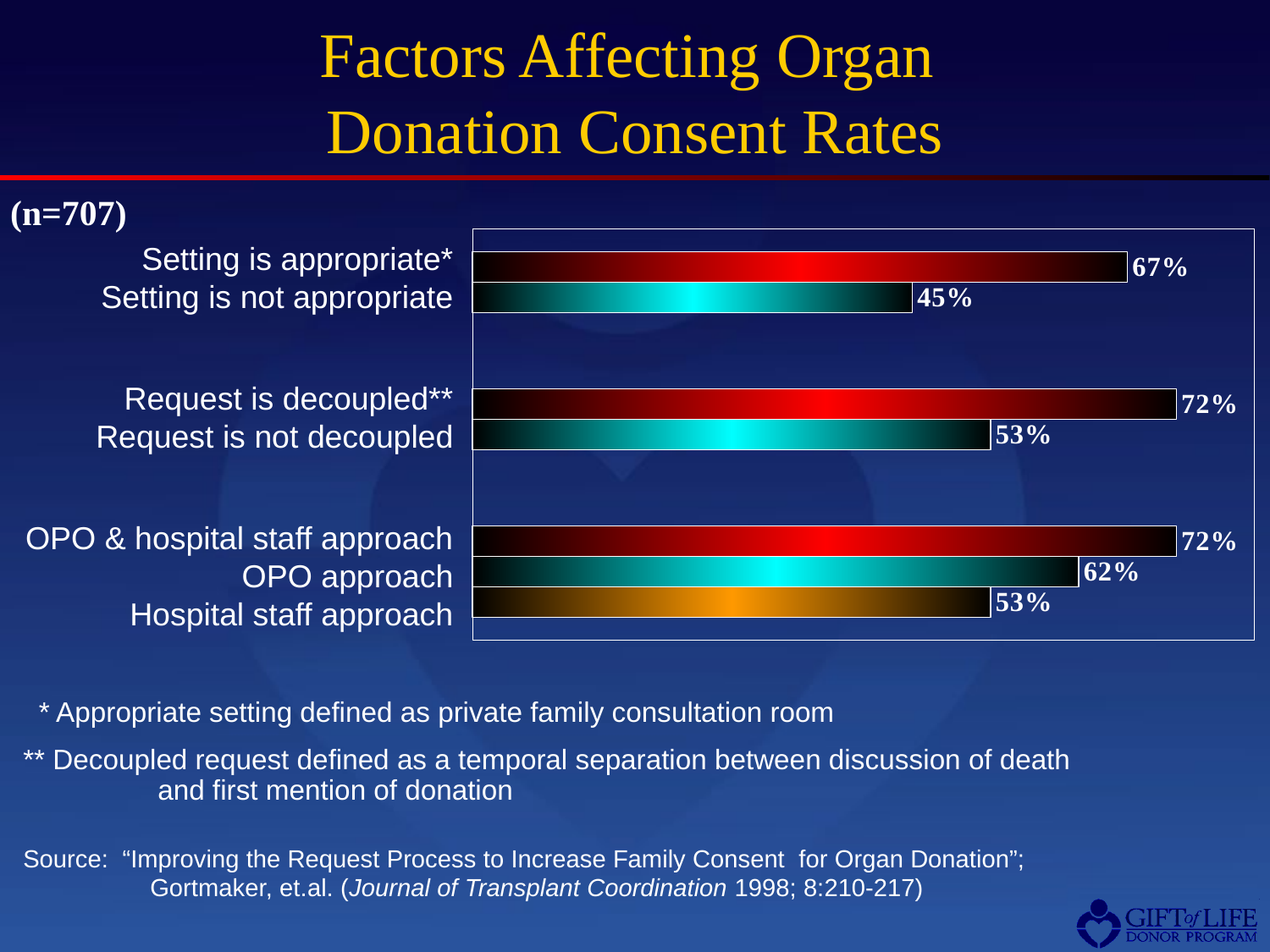
What is the consent rate for the hospital staff approach? 53% What is the difference in consent rate between a decoupled request and a request that is not decoupled? 19% What is the consent rate for the OPO approach? 62% Which category has the lowest consent rate? Setting is not appropriate What is the difference in consent rate between an appropriate setting and a setting that is not appropriate? 22% What is the consent rate when the request is decoupled? 72% What type of chart is shown on the slide? Bar chart What is the consent rate when the setting is not appropriate? 45% How many bars are plotted in the chart? 7 What is the consent rate when the setting is appropriate? 67% What sample size is stated next to the chart? n=707 Which has a higher consent rate, the OPO approach or the hospital staff approach? OPO approach